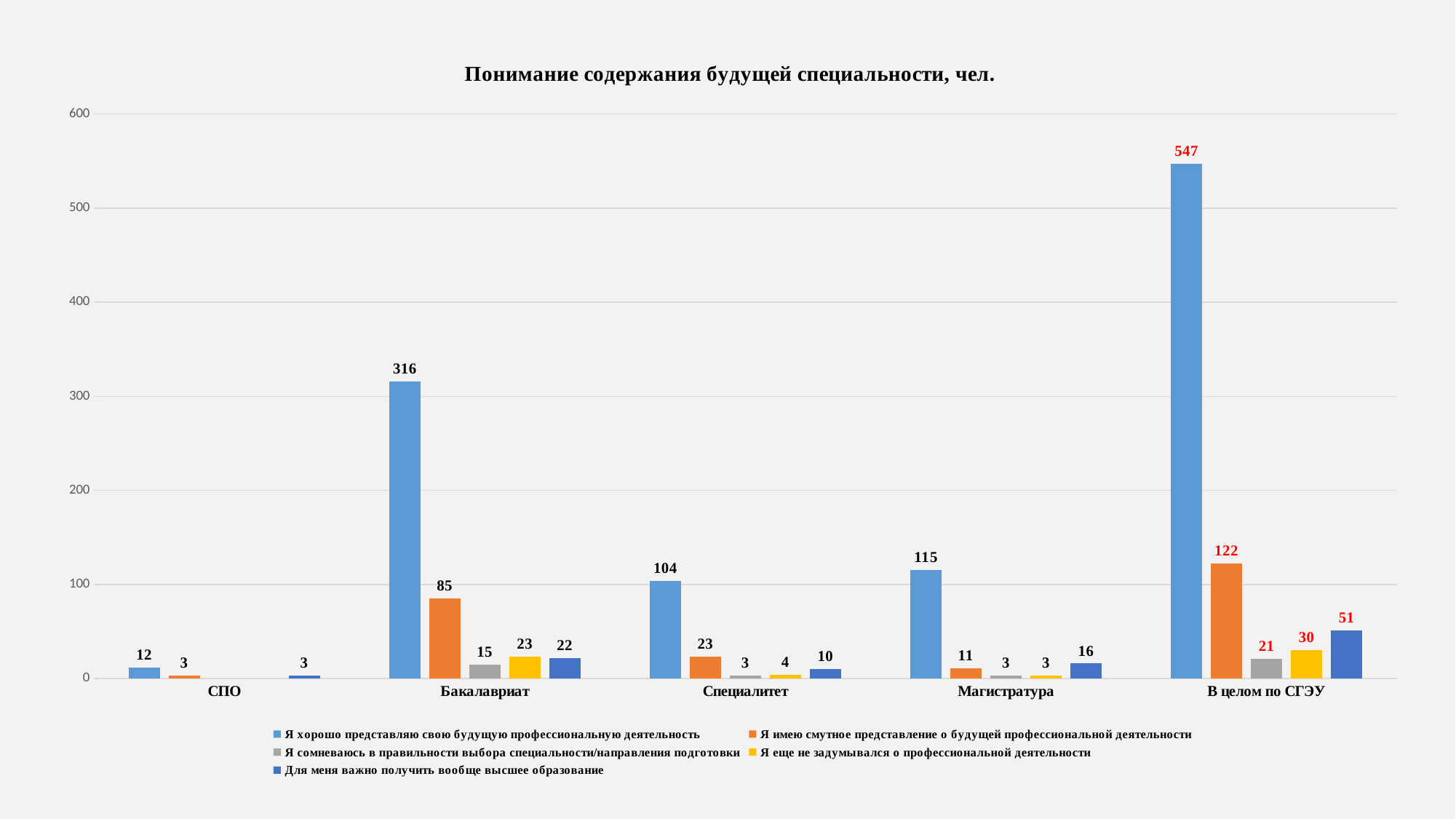
How many series does the legend list? 5 Which category has the highest value for "Я хорошо представляю свою будущую профессиональную деятельность"? В целом по СГЭУ What is the difference between the "Я хорошо представляю свою будущую профессиональную деятельность" values for Магистратура and Специалитет? 11 What is the value for "Я хорошо представляю свою будущую профессиональную деятельность" in the Бакалавриат category? 316 What is the value for "Я имею смутное представление о будущей профессиональной деятельности" in the В целом по СГЭУ category? 122 What is the value for "Я еще не задумывался о профессиональной деятельности" in the Специалитет category? 4 Is the value for "Я хорошо представляю свою будущую профессиональную деятельность" in В целом по СГЭУ greater or less than 500? greater What is the value for "Для меня важно получить вообще высшее образование" in the Магистратура category? 16 What kind of chart is shown on the slide? Bar chart Which category has the lowest value for "Я хорошо представляю свою будущую профессиональную деятельность"? СПО How many categories are shown on the x axis? 5 Which is larger: the "Я имею смутное представление о будущей профессиональной деятельности" value for Бакалавриат or for Специалитет? Бакалавриат